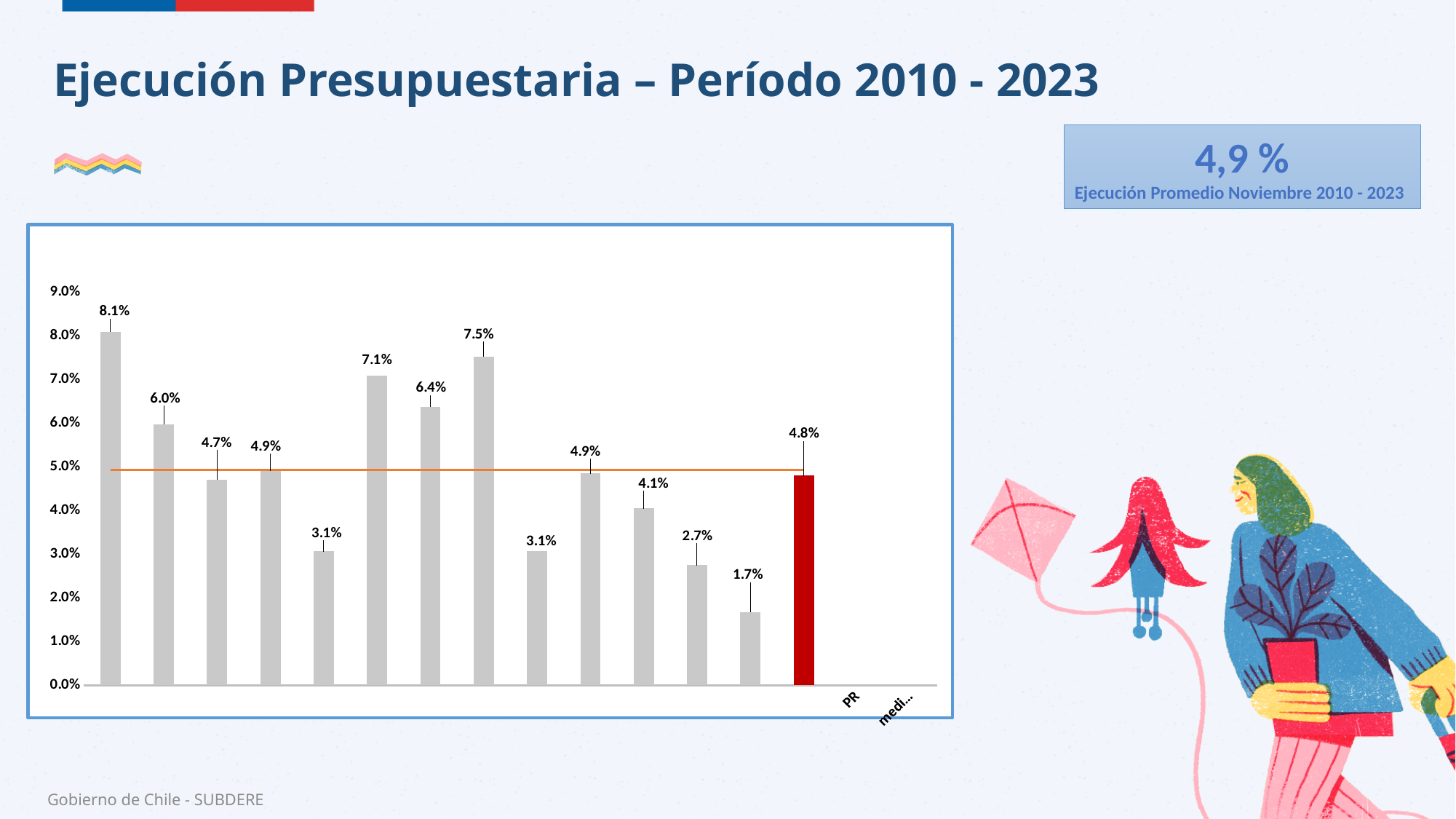
What average execution value is shown in the box at the top right of the slide? 4,9 % What value is labelled on the red bar at the right of the chart? 4.8% How many bars are plotted in the chart? 14 What is the difference between the highest bar (8.1%) and the lowest bar (1.7%)? 6.4 percentage points What is the highest value shown in the chart? 8.1% What value is labelled on the first (leftmost) bar of the chart? 8.1% Is the value of the red bar greater or less than 5.0%? less How many bars have a value above 7.0%? 3 What type of chart is shown on the slide? bar chart Which is larger: the value of the first bar or the value of the red bar? the first bar (8.1%) What colour is the last bar in the chart? red What is the lowest value shown in the chart? 1.7%